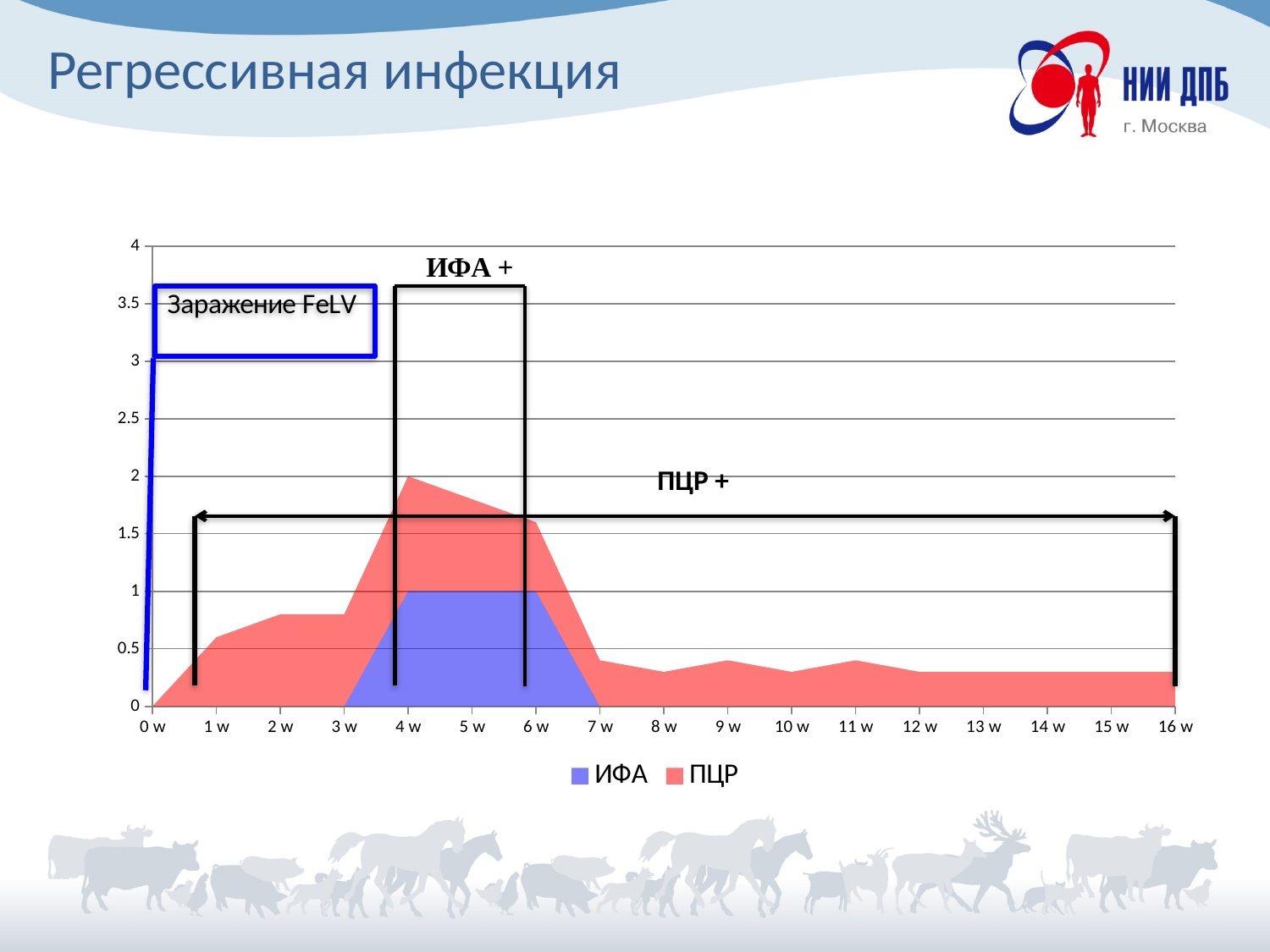
What is the value of the ИФА series at 5 w? 1 Does the ПЦР series rise or fall between 4 w and 7 w? fall How many series does the legend list? 2 Is the value of the ПЦР series at 10 w greater or less than 0.5? less How many time points are shown on the x axis? 17 What is the title of the slide? Регрессивная инфекция At which week does the ПЦР series reach its highest value? 4 w Is the value of the ПЦР series at 2 w greater or less than 1? less What kind of chart is shown on the slide? area chart